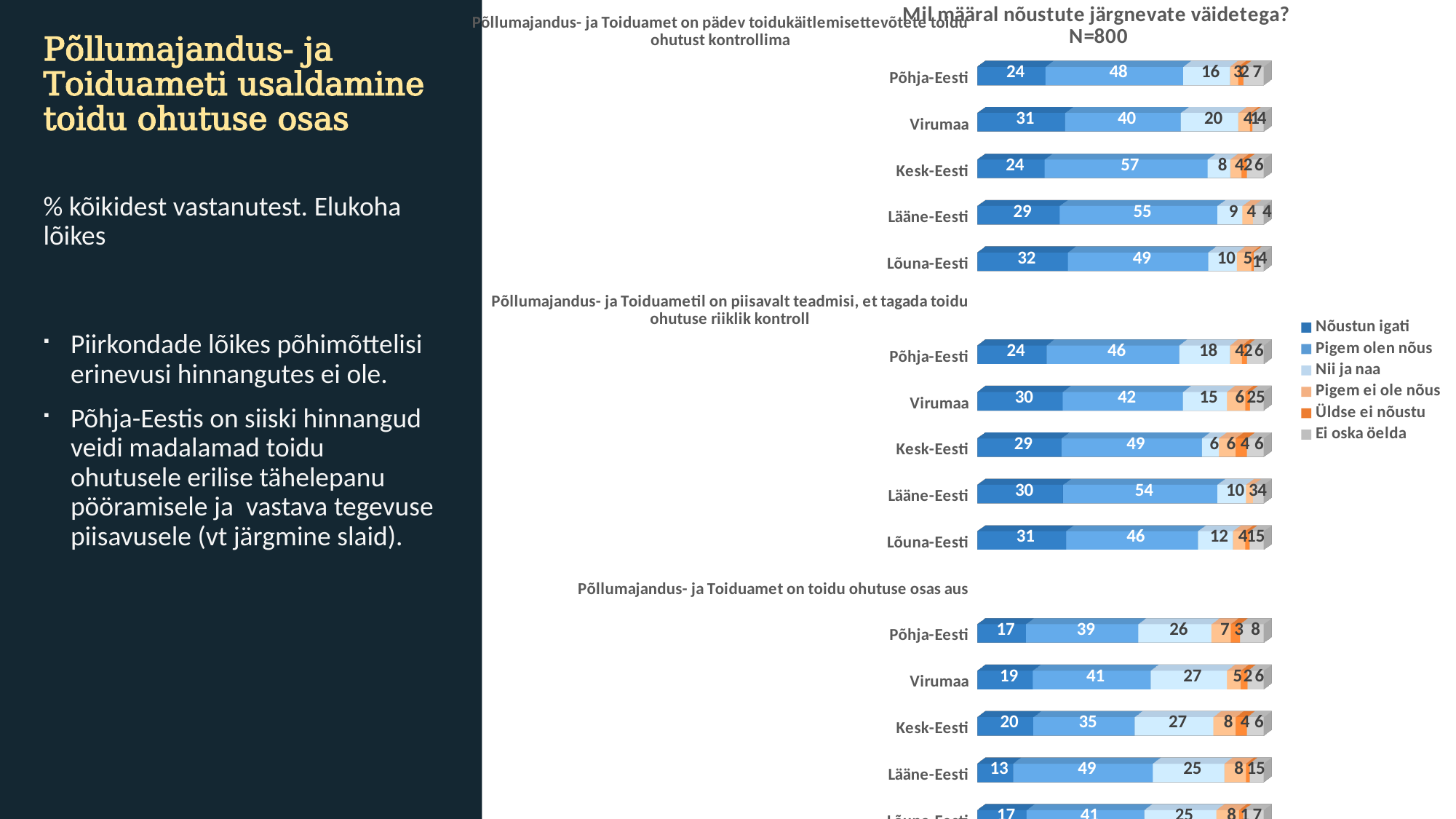
For the statement 'Põllumajandus- ja Toiduamet on pädev toidukäitlemisettevõtete toidu ohutust kontrollima', which region has the highest 'Pigem olen nõus' value? Kesk-Eesti For the statement 'Põllumajandus- ja Toiduamet on pädev toidukäitlemisettevõtete toidu ohutust kontrollima', what is the difference between the 'Pigem olen nõus' values for Kesk-Eesti and Virumaa? 17 For the statement 'Põllumajandus- ja Toiduamet on pädev toidukäitlemisettevõtete toidu ohutust kontrollima', what is the 'Nõustun igati' value for Lõuna-Eesti? 32 For the statement 'Põllumajandus- ja Toiduametil on piisavalt teadmisi, et tagada toidu ohutuse riiklik kontroll', what is the 'Nii ja naa' value for Põhja-Eesti? 18 For the statement 'Põllumajandus- ja Toiduamet on toidu ohutuse osas aus', which region has the lowest 'Nõustun igati' value? Lääne-Eesti What sample size (N) is stated in the chart title? N=800 For the statement 'Põllumajandus- ja Toiduamet on pädev toidukäitlemisettevõtete toidu ohutust kontrollima', what is the 'Pigem olen nõus' value for Kesk-Eesti? 57 How many series does the chart legend list? 6 For the statement 'Põllumajandus- ja Toiduamet on toidu ohutuse osas aus', what is the 'Pigem olen nõus' value for Lääne-Eesti? 49 How many regions are shown for each statement in the chart? 5 What kind of chart is shown on the slide? Stacked bar chart For the statement 'Põllumajandus- ja Toiduamet on pädev toidukäitlemisettevõtete toidu ohutust kontrollima', which region has the larger 'Nõustun igati' value, Lõuna-Eesti or Põhja-Eesti? Lõuna-Eesti